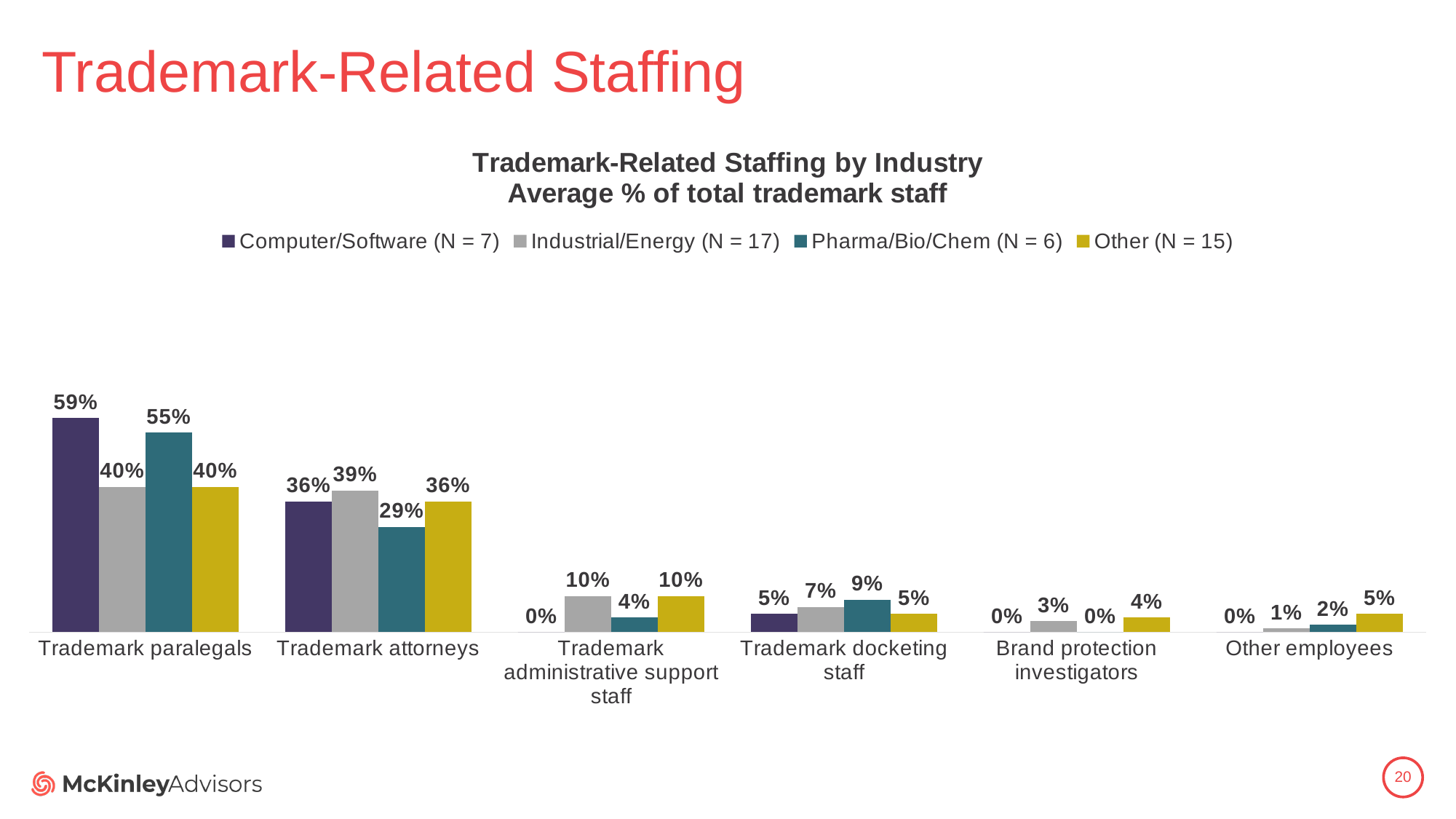
How many series does the legend list? 4 What is the value for Industrial/Energy (N = 17) in the Brand protection investigators category? 3% What is the difference between the Computer/Software (N = 7) and Industrial/Energy (N = 17) values for Trademark paralegals? 19% What is the value for Computer/Software (N = 7) in the Trademark paralegals category? 59% What is the value for Other (N = 15) in the Other employees category? 5% What is the title of the chart? Trademark-Related Staffing by Industry Average % of total trademark staff Which is larger for Trademark docketing staff: the Industrial/Energy (N = 17) value or the Pharma/Bio/Chem (N = 6) value? Pharma/Bio/Chem (N = 6) Which industry has the lowest value in the Trademark attorneys category? Pharma/Bio/Chem (N = 6) What is the value for Pharma/Bio/Chem (N = 6) in the Trademark attorneys category? 29% What kind of chart is shown on the slide? Bar chart How many staffing categories are shown on the x axis? 6 Which industry has the highest value in the Trademark paralegals category? Computer/Software (N = 7)